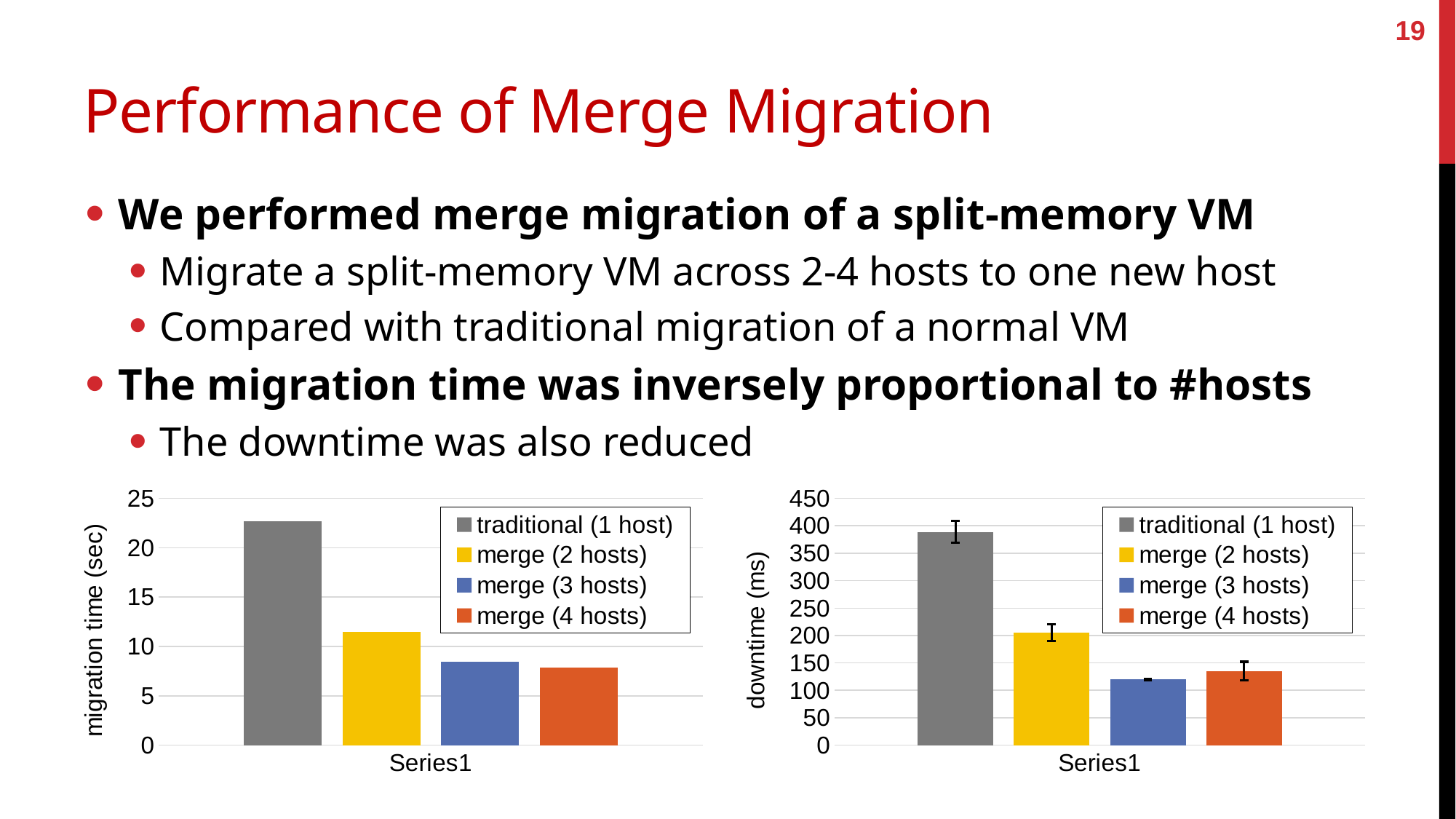
In the right chart (downtime), is the value for merge (4 hosts) greater or less than 150? less In the left chart (migration time), is the value for merge (3 hosts) greater or less than 10? less In the left chart (migration time), what colour is the bar for merge (2 hosts)? yellow In the right chart (downtime), is the value for merge (3 hosts) greater or less than 100? greater In the left chart (migration time), which series has the highest value? traditional (1 host) What is the y-axis label of the right chart? downtime (ms) In the left chart (migration time), which is larger: merge (2 hosts) or merge (3 hosts)? merge (2 hosts) How many series does the legend of the right chart (downtime) list? 4 In the right chart (downtime), which series has the highest value? traditional (1 host) What kind of chart is the left chart (migration time)? bar chart